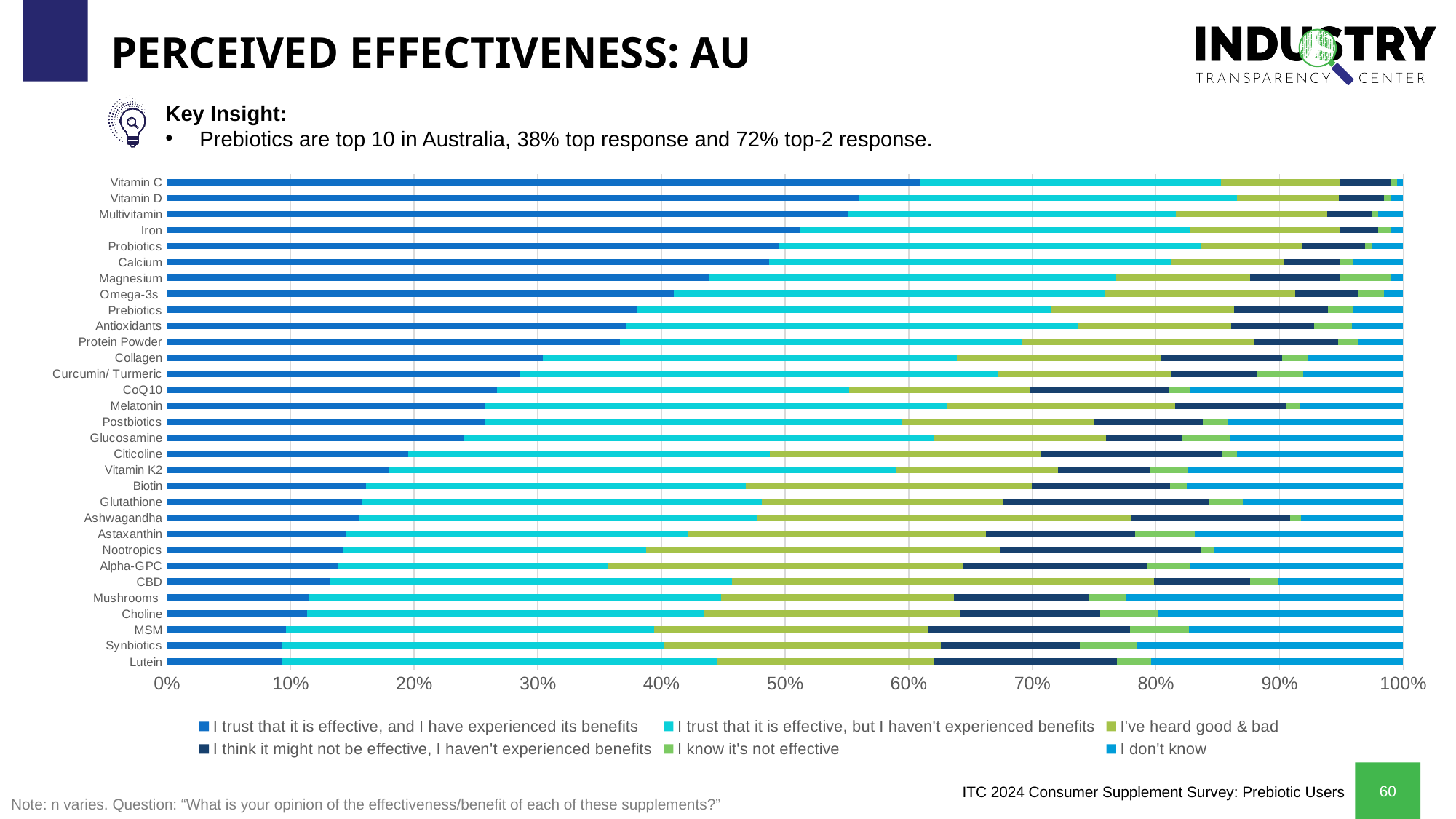
Is the "I trust that it is effective, and I have experienced its benefits" share for Vitamin C greater or less than 50%? greater How many supplement categories are listed on the chart? 31 Which supplement has the largest share for "I trust that it is effective, and I have experienced its benefits"? Vitamin C Is the "I trust that it is effective, and I have experienced its benefits" share for Magnesium greater or less than 40%? greater Is the "I trust that it is effective, and I have experienced its benefits" share for CBD greater or less than 20%? less Which supplement is listed at the bottom of the chart? Lutein What is the title of the slide? PERCEIVED EFFECTIVENESS: AU How many series does the legend list? 6 Which has a larger "I trust that it is effective, and I have experienced its benefits" share, Vitamin D or Mushrooms? Vitamin D Moving from the top of the chart to the bottom, does the "I trust that it is effective, and I have experienced its benefits" share rise or fall? fall What kind of chart is shown on the slide? Stacked bar chart